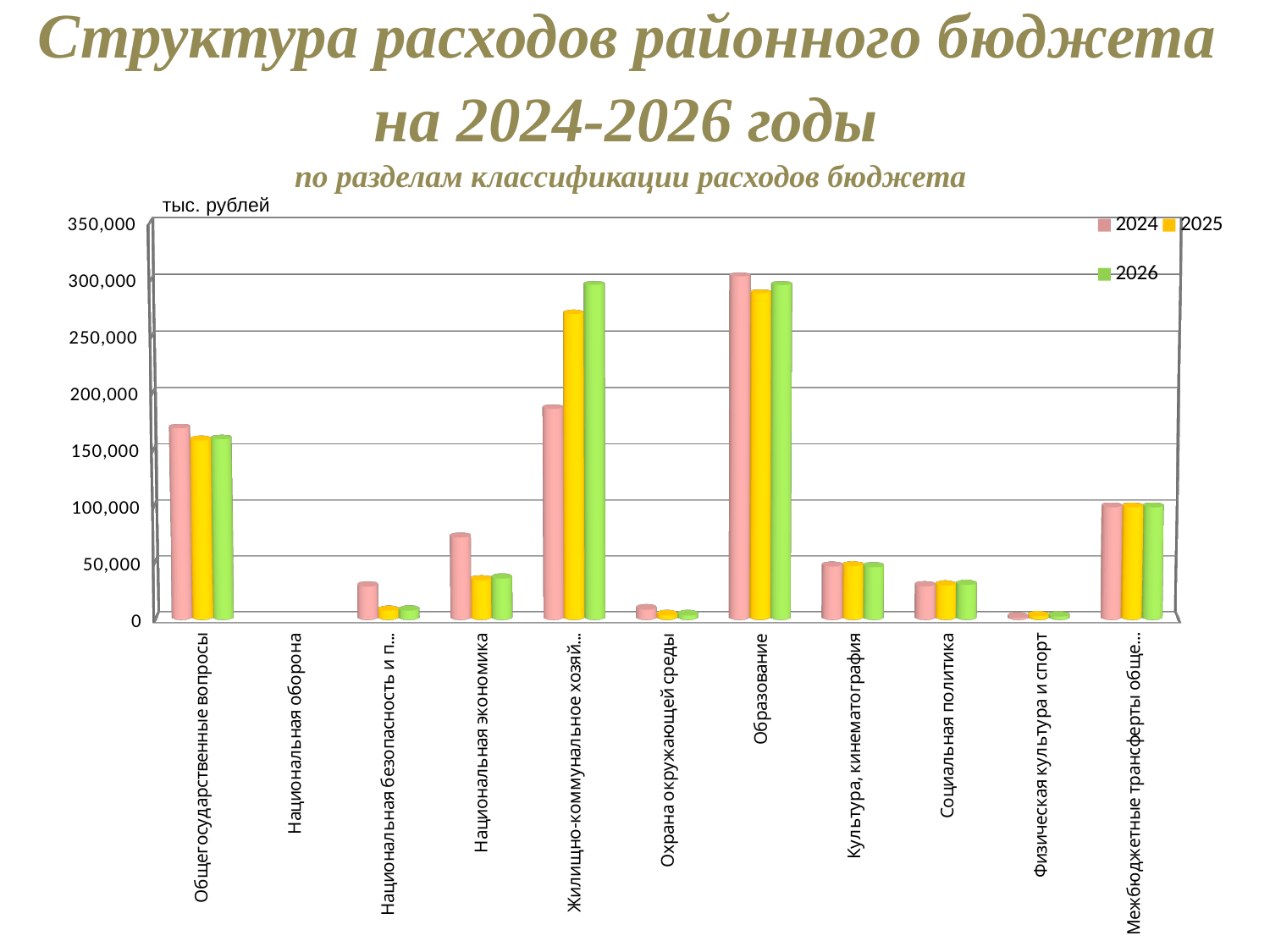
Do the values for Жилищно-коммунальное хозяйство rise or fall from 2024 to 2026? rise For Жилищно-коммунальное хозяйство, which is larger: the 2024 value or the 2026 value? 2026 Is the 2024 value for Жилищно-коммунальное хозяйство greater or less than 200,000? less Is the 2024 value for Образование greater or less than 250,000? greater What unit is indicated above the vertical axis of the chart? тыс. рублей How many expenditure categories are shown on the x axis? 11 Which category has the highest value for 2024? Образование Is the 2024 value for Национальная экономика greater or less than 50,000? greater What kind of chart is shown on the slide? bar chart Which category has the lowest values across all three years? Национальная оборона How many series does the legend list? 3 For Национальная экономика, which is larger: the 2024 value or the 2025 value? 2024